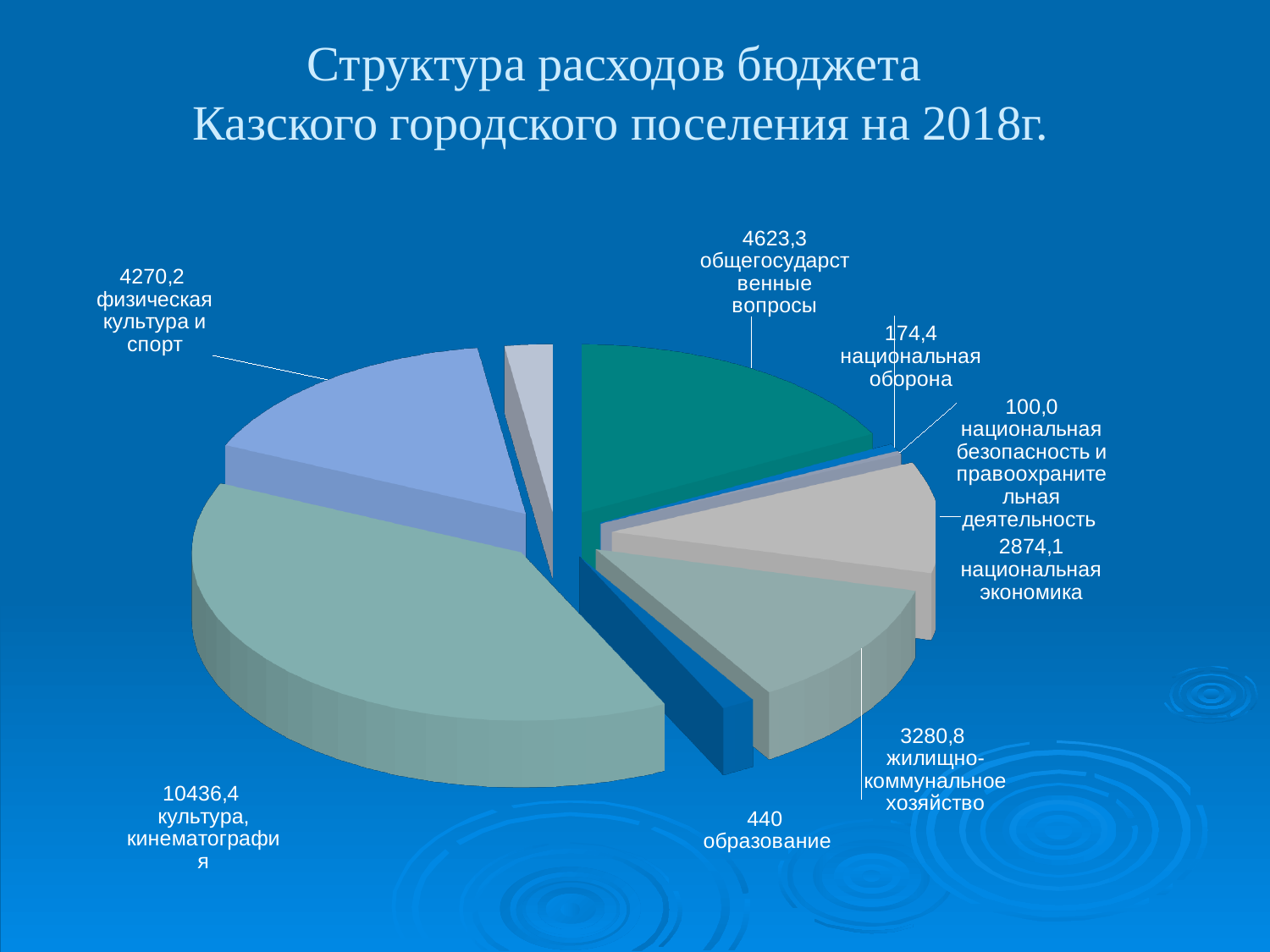
What is the title of the chart? Структура расходов бюджета Казского городского поселения на 2018г. What is the value for образование? 440 What is the difference between культура, кинематография and общегосударственные вопросы? 5813,1 What type of chart is shown on the slide? pie chart What is the difference between жилищно-коммунальное хозяйство and национальная экономика? 406,7 What is the value for национальная оборона? 174,4 What is the value for общегосударственные вопросы? 4623,3 Which category has the largest value? культура, кинематография Among the labelled categories, which has the smallest value? национальная безопасность и правоохранительная деятельность What is the value for жилищно-коммунальное хозяйство? 3280,8 Which is larger: общегосударственные вопросы or физическая культура и спорт? общегосударственные вопросы What is the value for культура, кинематография? 10436,4